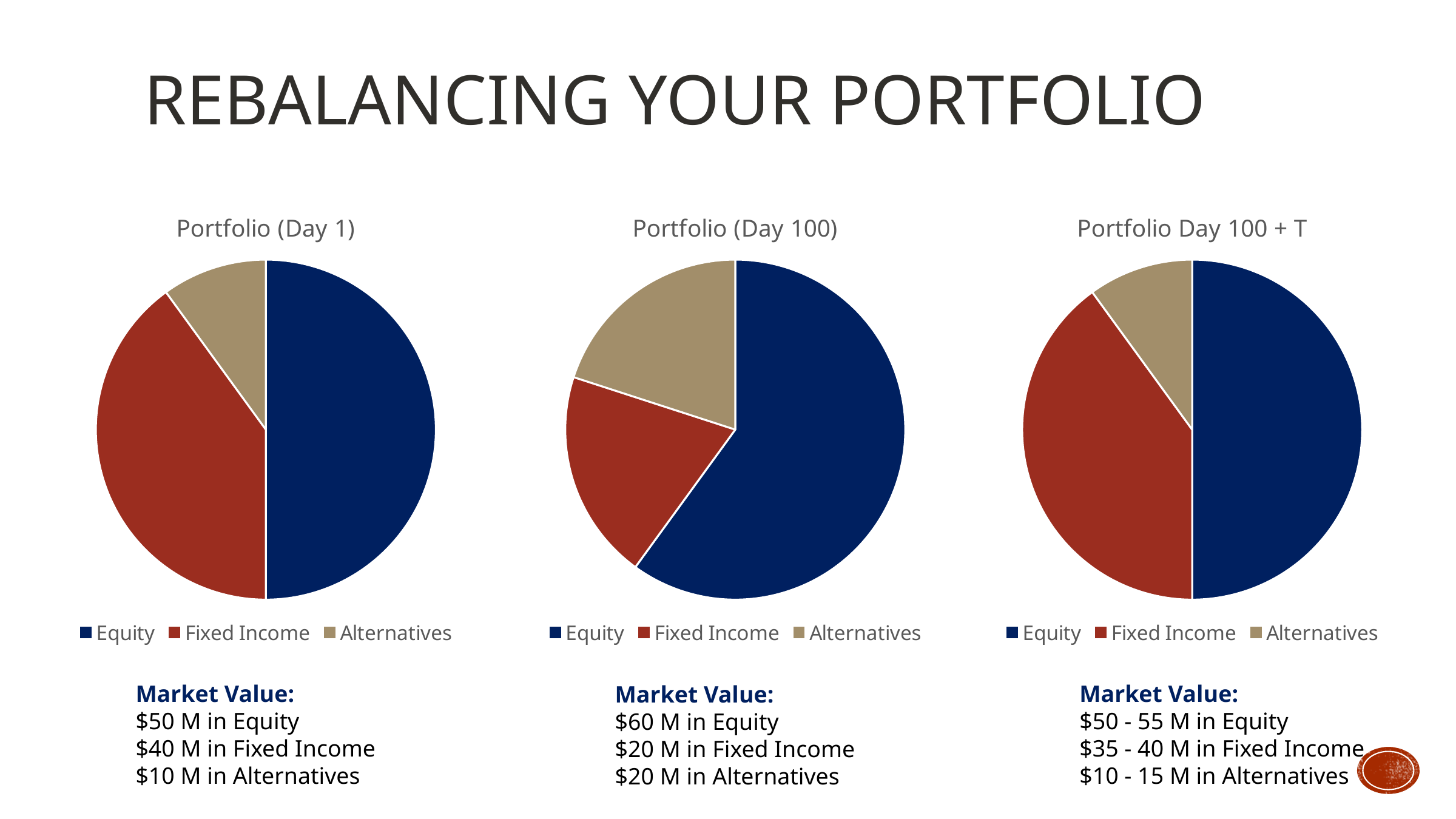
What is the title of the rightmost chart on the slide? Portfolio Day 100 + T In the Portfolio (Day 100) chart, what is the market value in Alternatives? $20 M In the Portfolio (Day 1) chart, which category has the largest slice? Equity How many entries does the legend of the Portfolio Day 100 + T chart list? 3 In the Portfolio (Day 1) chart, what is the difference between the Equity and Alternatives market values? $40 M In the Portfolio Day 100 + T chart, which category has the smallest slice? Alternatives How many slices does the Portfolio (Day 100) pie chart have? 3 In the Portfolio (Day 100) chart, what share of the pie does Equity represent? 60% What kind of chart is the Portfolio (Day 1) chart? Pie chart In the Portfolio (Day 1) chart, what is the market value in Fixed Income? $40 M In the Portfolio (Day 100) chart, is the Equity slice larger or smaller than the Fixed Income slice? Larger